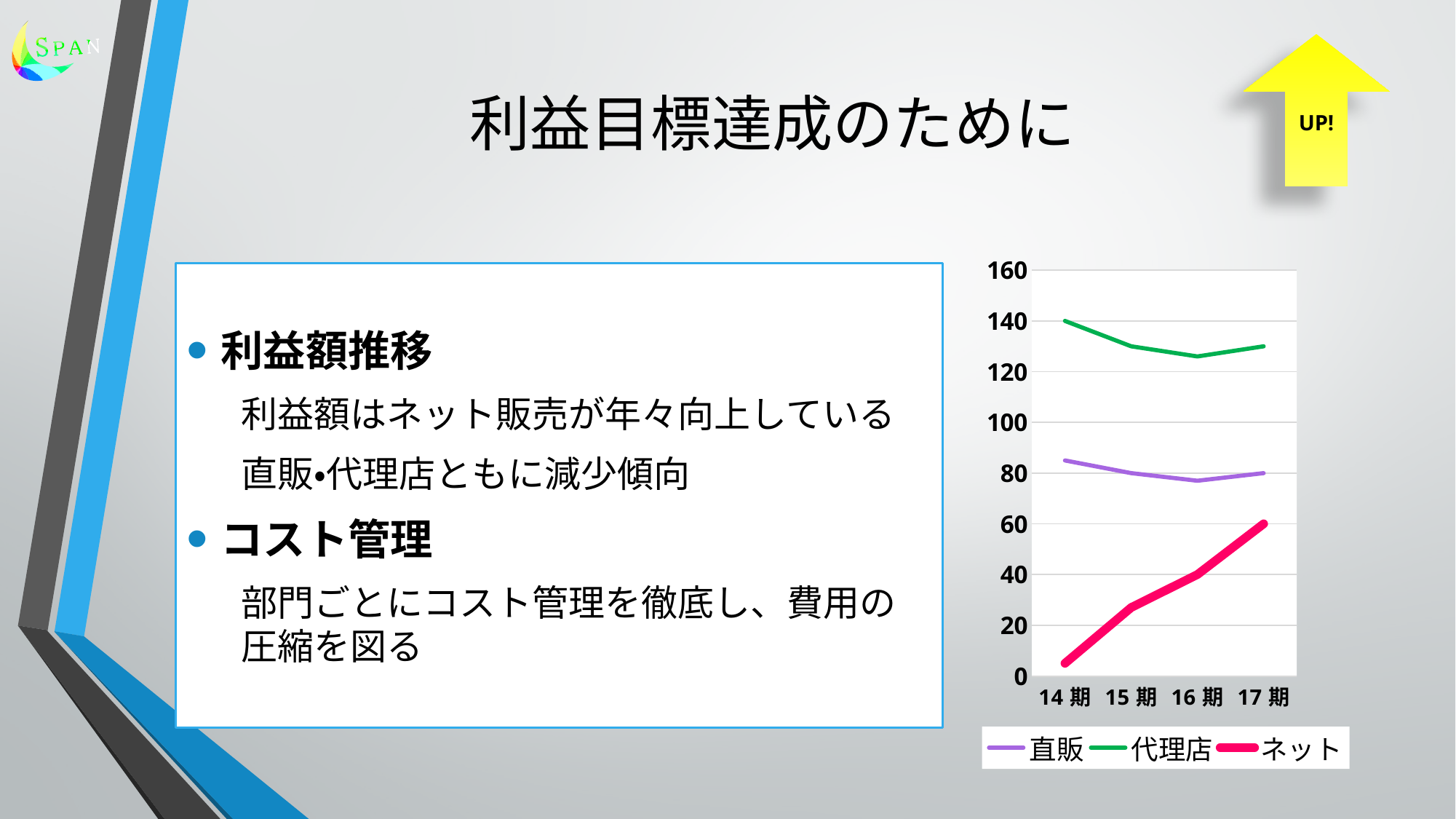
Is the value for ネット at 15期 greater or less than 40? less What is the value for 代理店 at 14期? 140 How many series does the chart legend list? 3 Is the value for 直販 at 16期 greater or less than 80? less What kind of chart is shown on the slide? line chart Overall, does the 代理店 line rise or fall from 14期 to 17期? fall Does the ネット line rise or fall from 14期 to 17期? rise How many periods are shown on the x axis of the chart? 4 Which series has the lowest value at 17期? ネット Which series has the highest value at 14期? 代理店 Is the value for 代理店 at 16期 greater or less than 120? greater At 16期, which is larger, 直販 or ネット? 直販